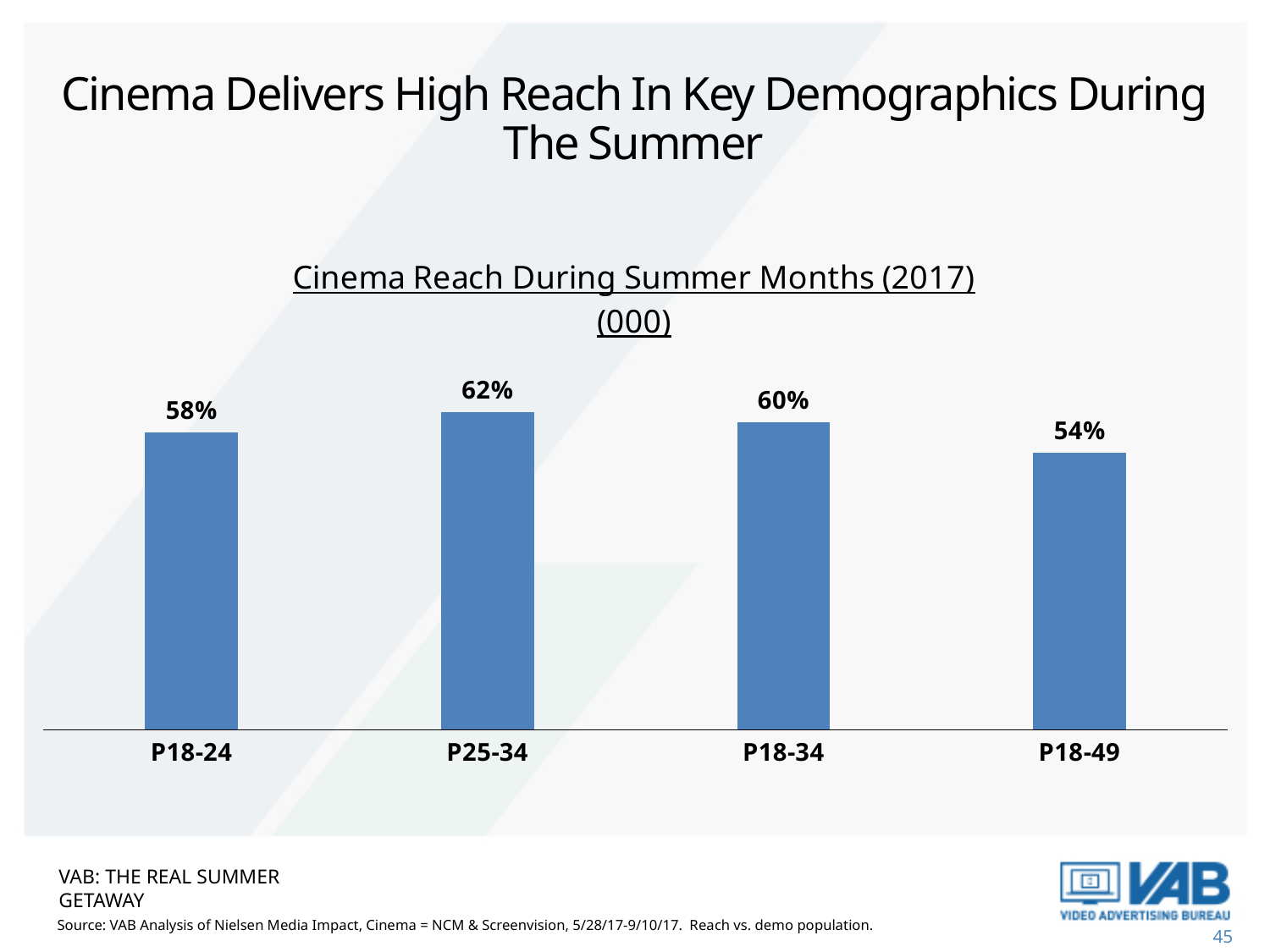
Which has a higher cinema reach, P18-24 or P18-49? P18-24 What is the difference between the cinema reach for P25-34 and P18-49? 8% What is the cinema reach value for P25-34? 62% What is the title of the chart? Cinema Reach During Summer Months (2017) (000) Which demographic has the lowest cinema reach? P18-49 What type of chart is shown on the slide? Bar chart How many demographic categories are shown in the chart? 4 What is the cinema reach value for P18-49? 54% Which demographic has the highest cinema reach? P25-34 What is the cinema reach value for P18-34? 60% What is the cinema reach value for P18-24? 58% What is the difference between the cinema reach for P18-34 and P18-24? 2%